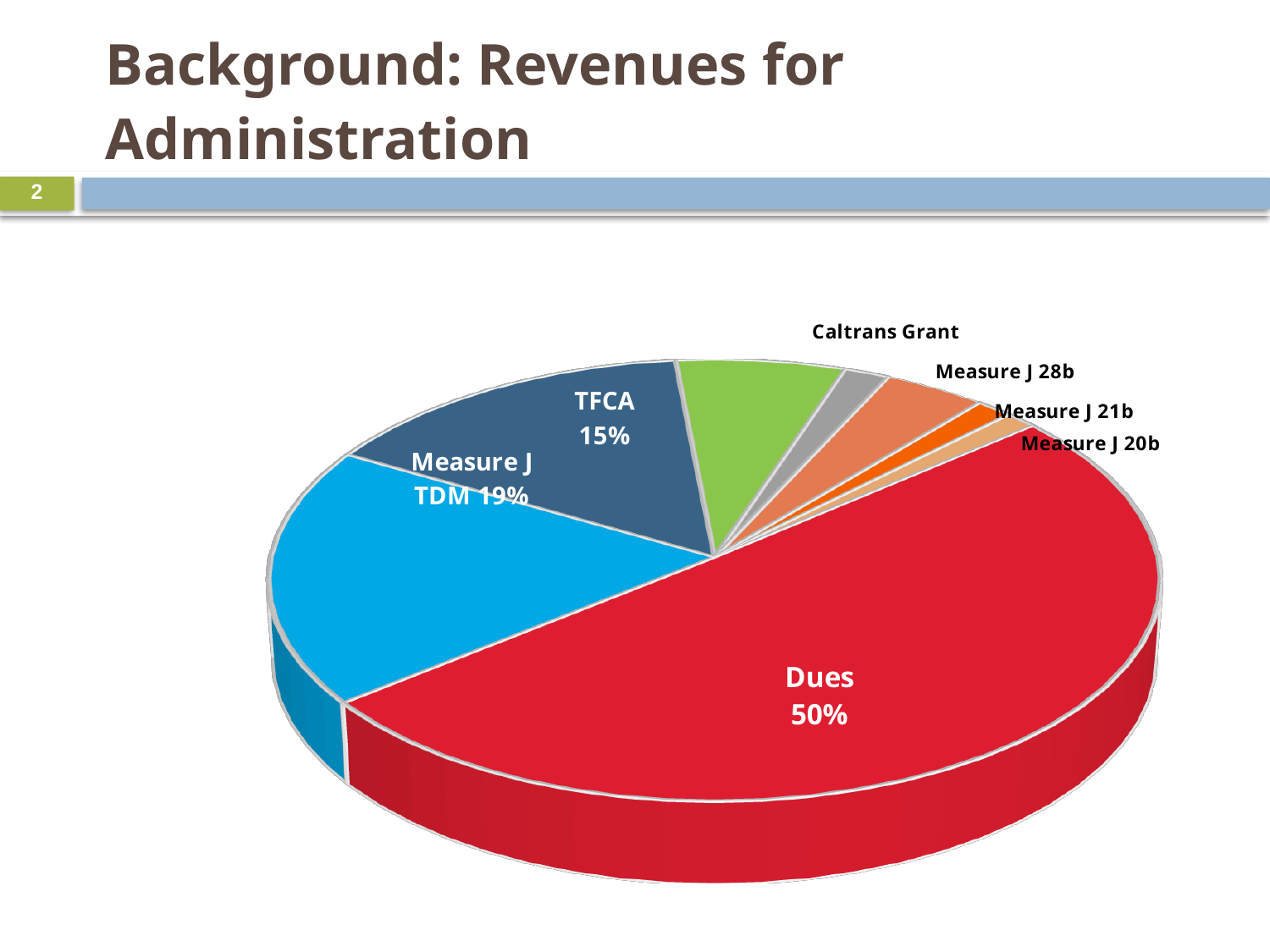
What share of the pie does the Dues slice represent? 50% What is the difference in percentage points between Measure J TDM and TFCA? 4% Which is larger, the Measure J TDM slice or the TFCA slice? Measure J TDM What percentage of revenues for administration comes from Dues? 50% What is the difference in percentage points between Dues and TFCA? 35% Which revenue source has the largest slice of the pie? Dues What percentage is shown for TFCA? 15% What kind of chart is shown on the slide? pie chart What percentage is shown for Measure J TDM? 19% What is the difference in percentage points between Dues and Measure J TDM? 31% What is the title of the slide containing the pie chart? Background: Revenues for Administration Which is larger, the Dues slice or the Caltrans Grant slice? Dues